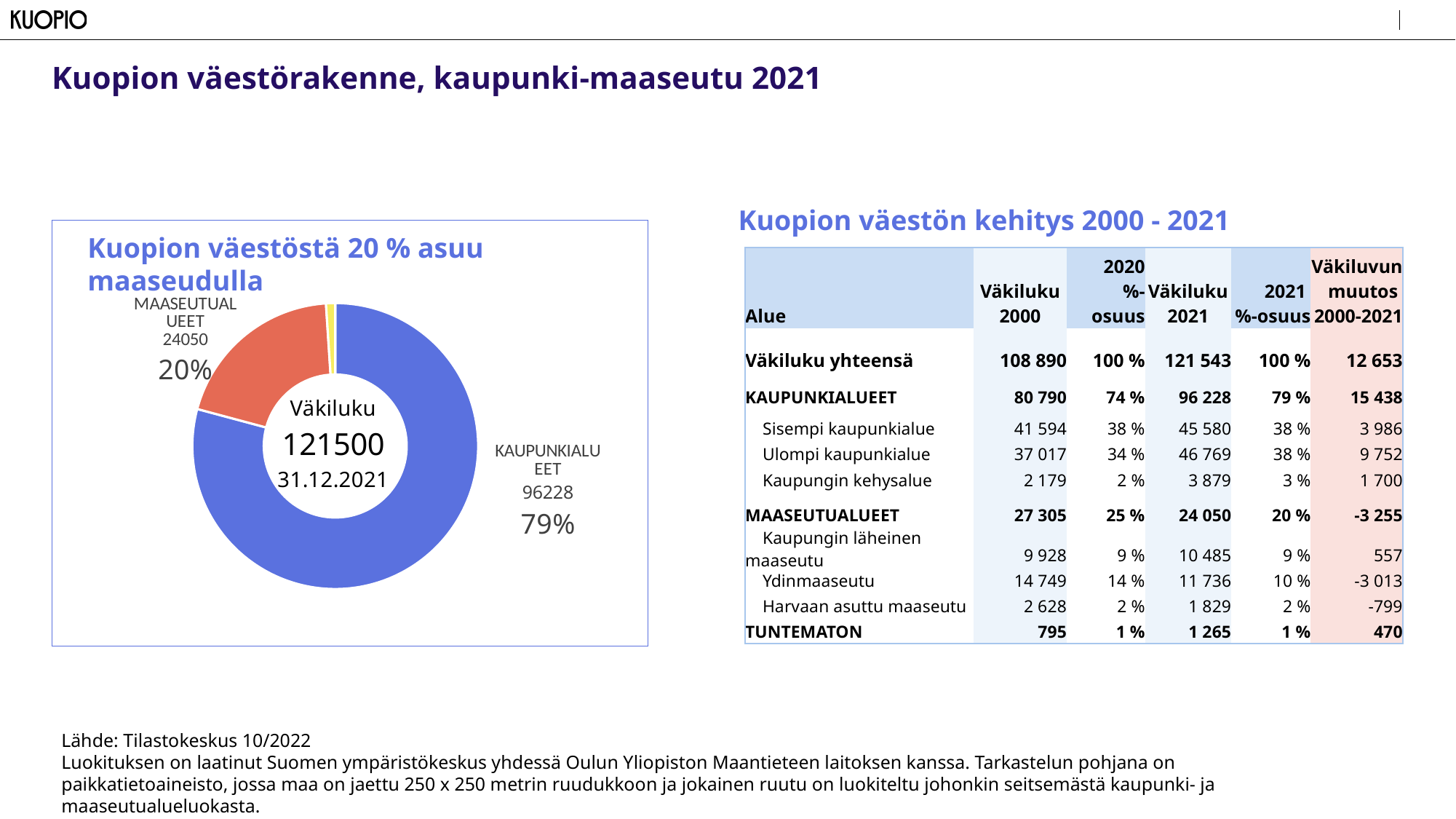
In the doughnut chart, which is larger, KAUPUNKIALUEET or MAASEUTUALUEET? KAUPUNKIALUEET In the doughnut chart, what share of the population lives in MAASEUTUALUEET? 20% Which slice of the doughnut chart is the largest? KAUPUNKIALUEET In the doughnut chart, what is the value for MAASEUTUALUEET? 24050 What kind of chart is shown on the left of the slide? doughnut chart In the doughnut chart, what is the value for KAUPUNKIALUEET? 96228 In the doughnut chart, what share of the population lives in KAUPUNKIALUEET? 79% What total population (Väkiluku) is printed in the centre of the doughnut chart? 121500 What date is printed in the centre of the doughnut chart? 31.12.2021 How many slices does the doughnut chart have? 3 What is the title of the doughnut chart? Kuopion väestöstä 20 % asuu maaseudulla In the doughnut chart, what is the difference between the KAUPUNKIALUEET value and the MAASEUTUALUEET value? 72178